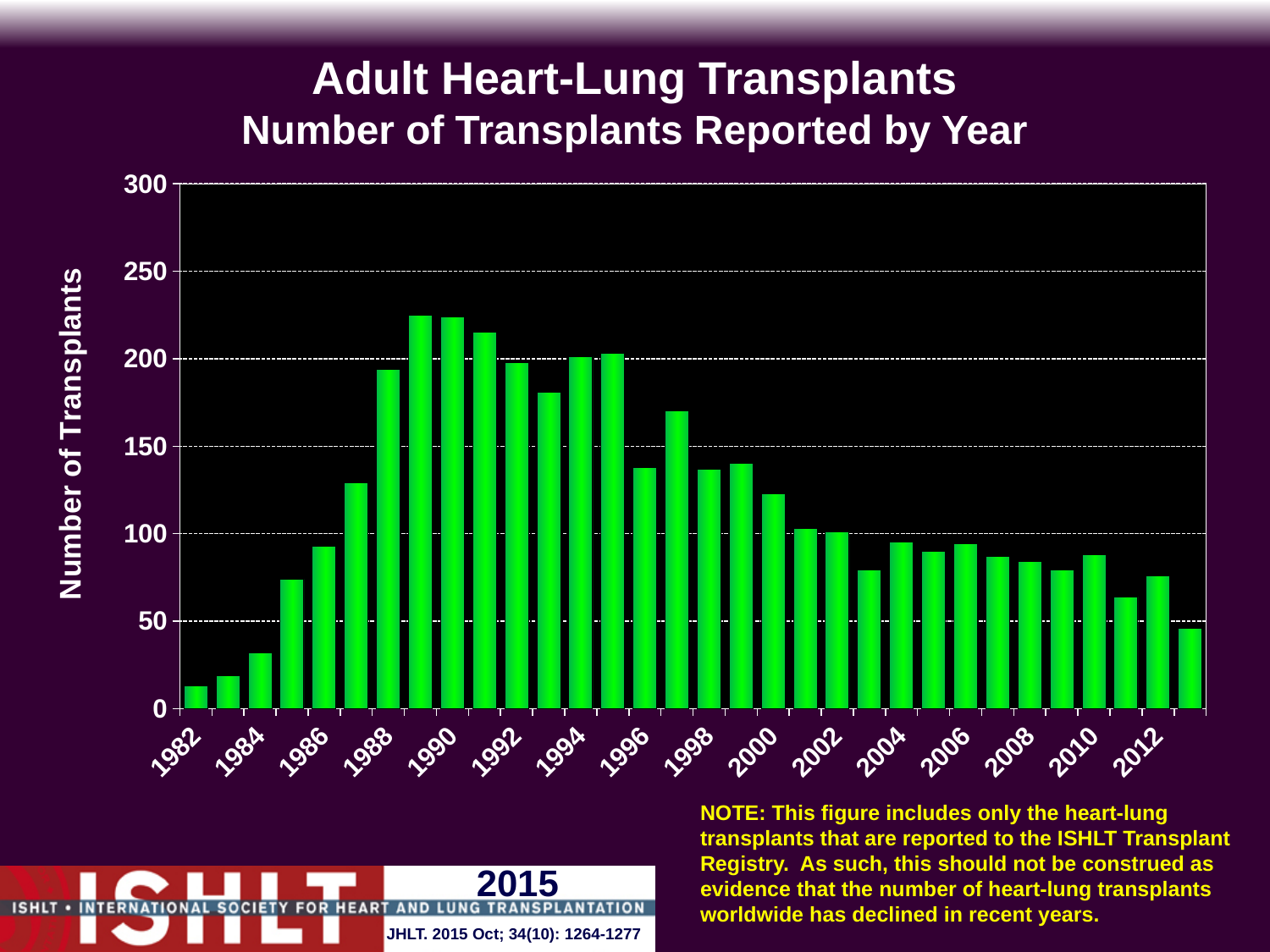
Is the value for 1985 greater or less than 50? greater Which year has the lowest number of transplants? 1982 What is the title of the vertical axis? Number of Transplants Is the value for 1988 greater or less than 150? greater What kind of chart is shown on the slide? bar chart Do the values rise or fall from 1982 to 1989? rise Is the value for 1991 greater or less than 200? greater Do the values generally rise or fall from 1995 to 2013? fall Which year has the larger number of transplants, 1988 or 2008? 1988 Which year has the larger number of transplants, 1984 or 2012? 2012